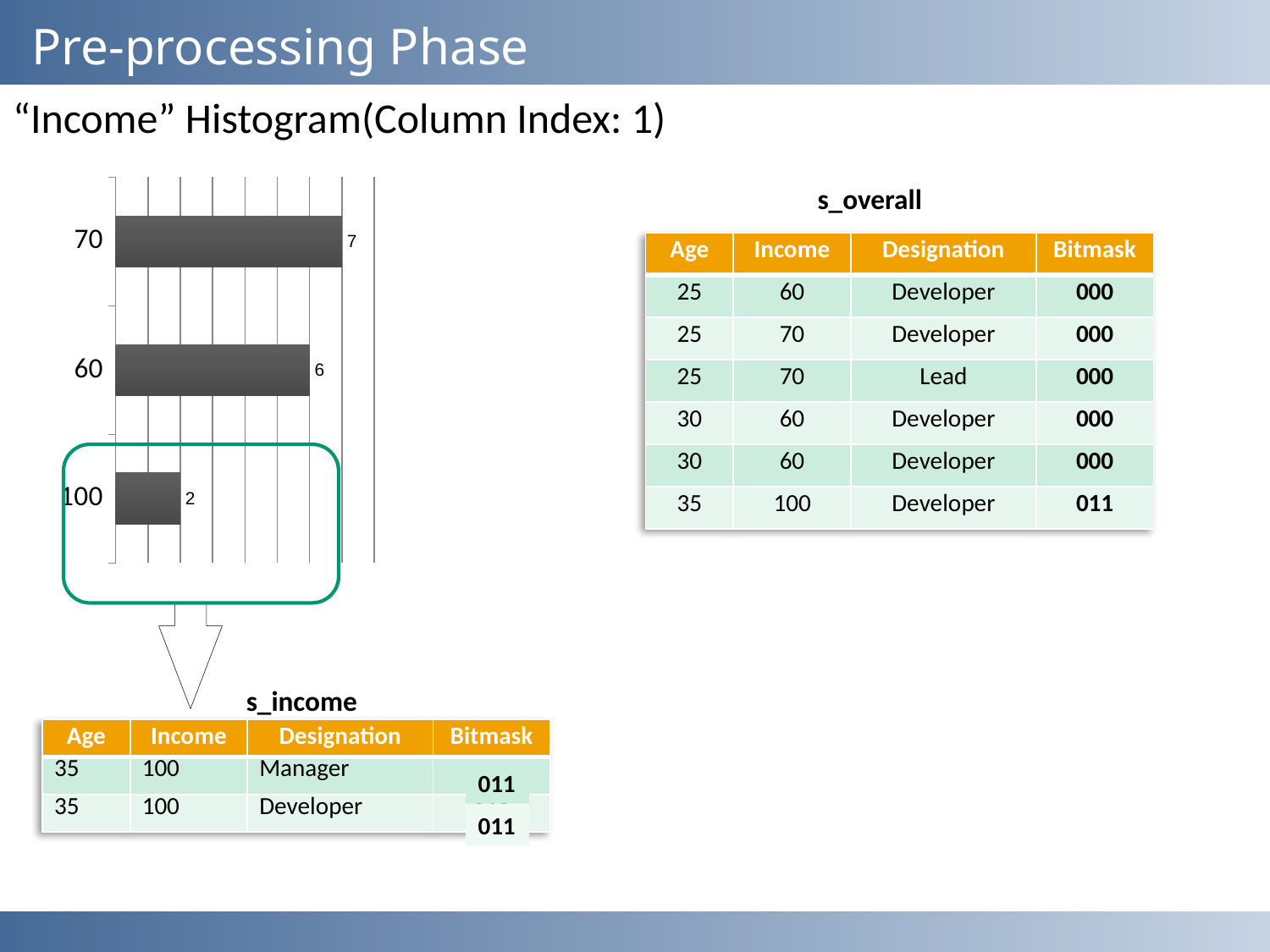
Which bar in the "Income" histogram is enclosed by the green rounded outline? 100 What is the value of the bar for income category 60 in the "Income" histogram? 6 What is the title of the chart on the slide? "Income" Histogram(Column Index: 1) What is the value of the bar for income category 100 in the "Income" histogram? 2 Which income category has the highest bar in the "Income" histogram? 70 What kind of chart is the "Income" histogram on the slide? Bar chart In the "Income" histogram, which has a larger value: category 60 or category 100? 60 In the "Income" histogram, what is the difference between the values for categories 70 and 100? 5 Which income category has the lowest bar in the "Income" histogram? 100 In the "Income" histogram, what is the difference between the values for categories 70 and 60? 1 How many bars are shown in the "Income" histogram? 3 What is the value of the bar for income category 70 in the "Income" histogram? 7